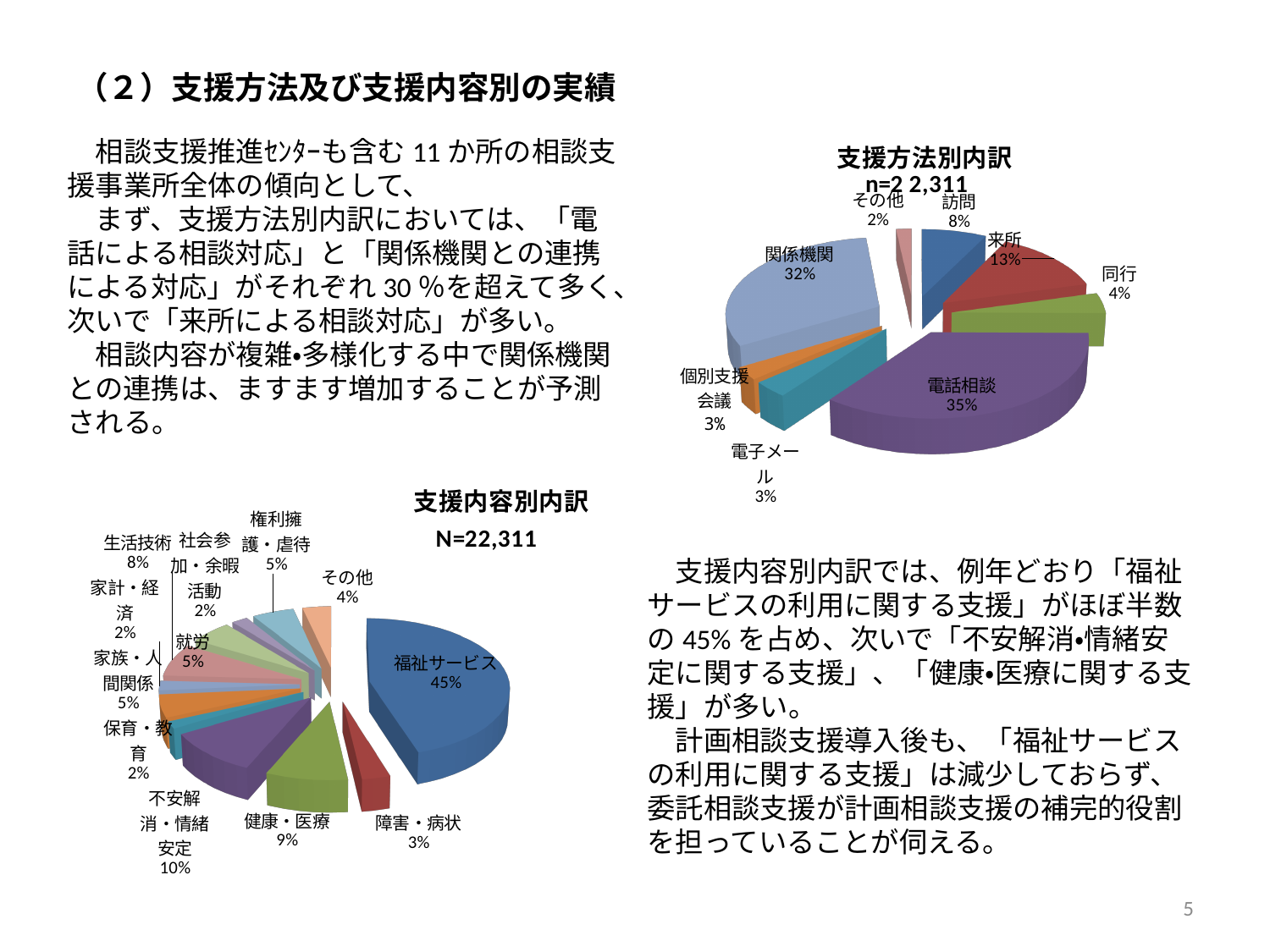
In the 支援方法別内訳 chart, what share does 電話相談 have? 35% In the 支援方法別内訳 chart, which category has the largest share? 電話相談 In the 支援方法別内訳 chart, how many categories are shown? 8 What kind of chart is the 支援内容別内訳 chart? Pie chart In the 支援方法別内訳 chart, which category has the smallest share? その他 In the 支援方法別内訳 chart, what share does 関係機関 have? 32% In the 支援方法別内訳 chart, what is the difference in percentage points between 来所 and 訪問? 5 In the 支援内容別内訳 chart, what share does 不安解消・情緒安定 have? 10% What is the N value shown under the title of the 支援内容別内訳 chart? N=22,311 In the 支援内容別内訳 chart, what share does 福祉サービス have? 45% In the 支援内容別内訳 chart, which is larger, 健康・医療 or 生活技術? 健康・医療 In the 支援内容別内訳 chart, how many categories are shown? 12